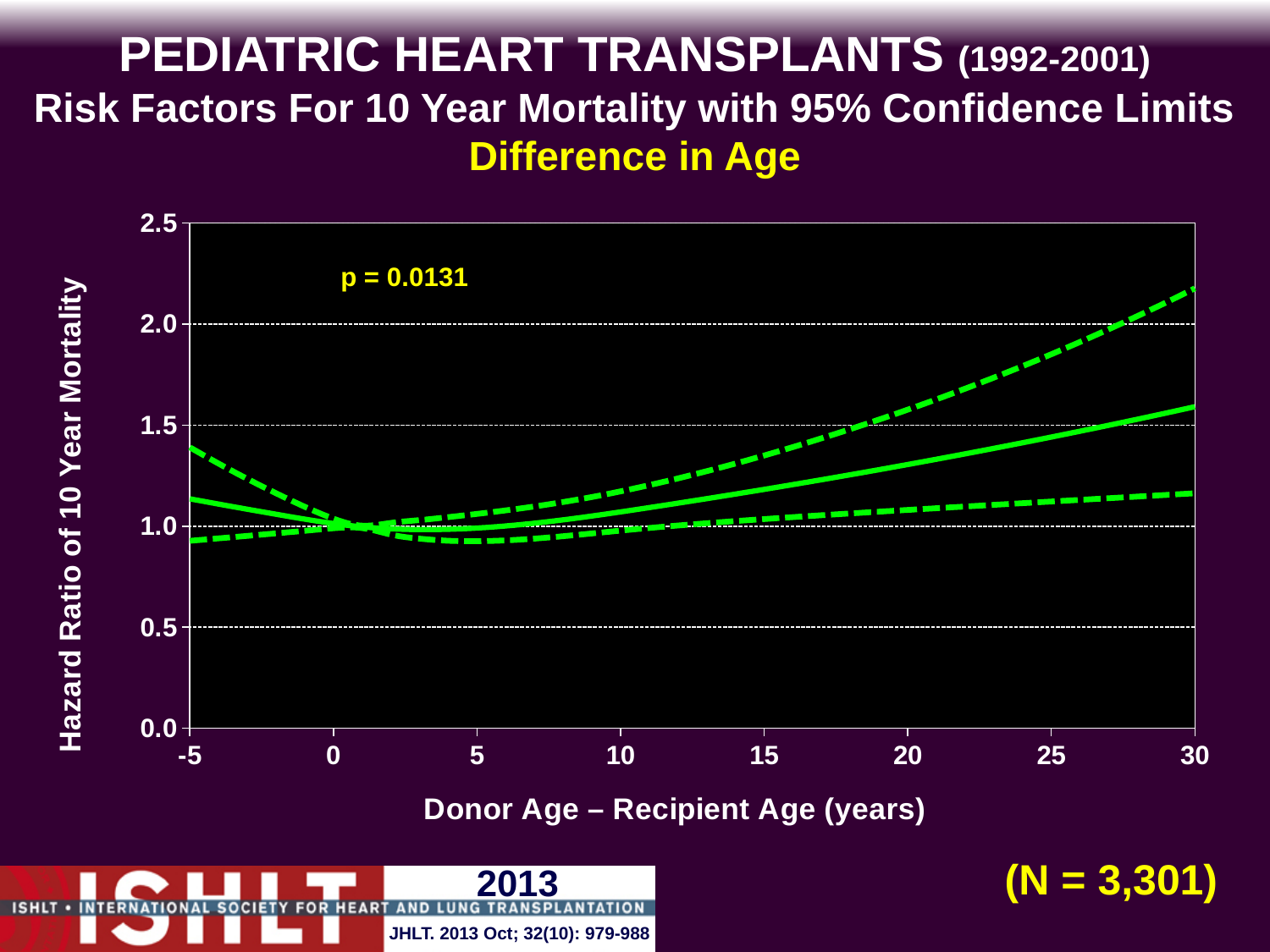
Is the value of the upper dashed confidence limit at an age difference of 30 years greater or less than 2.0? greater How many lines are plotted on the chart? 3 Does the upper dashed confidence limit rise or fall as the age difference goes from -5 to 0 years? fall Is the value of the upper dashed confidence limit at an age difference of -5 years greater or less than 1.0? greater Does the solid hazard ratio line rise or fall as the donor-recipient age difference increases from 5 to 30 years? rise What kind of chart is shown on the slide? line chart Is the value of the solid hazard ratio line at an age difference of 30 years greater or less than 2.0? less What sample size (N) is shown on the slide? N = 3,301 What p-value is printed on the chart? p = 0.0131